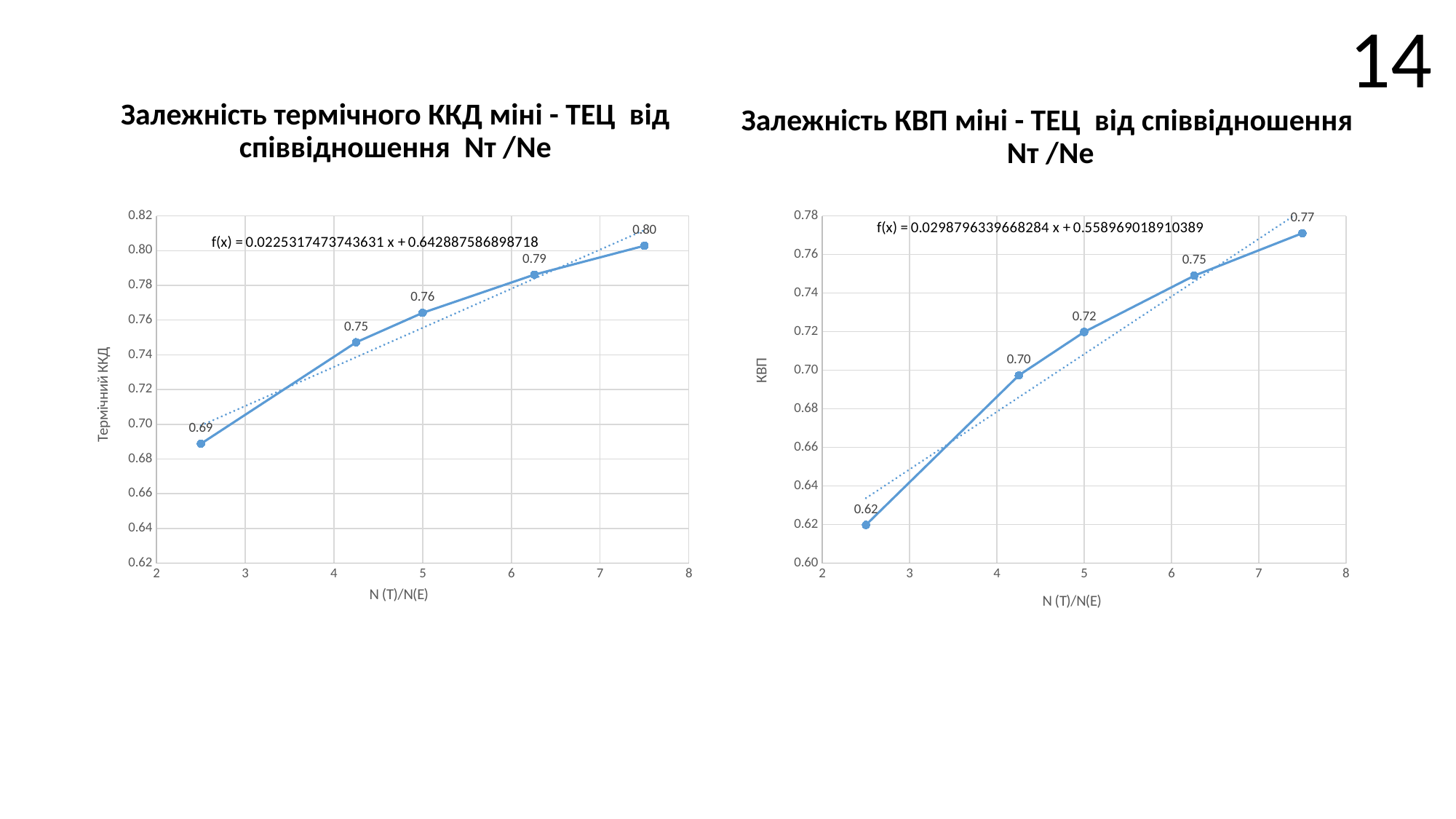
On the left chart (Залежність термічного ККД міні - ТЕЦ), do the values rise or fall as N (T)/N(E) increases? rise What is the x-axis title of the left chart (Залежність термічного ККД міні - ТЕЦ)? N (T)/N(E) On the right chart (Залежність КВП міні - ТЕЦ від співвідношення Nт /Ne), what is the data label of the first (leftmost) point? 0.62 On the right chart (Залежність КВП міні - ТЕЦ), what is the data label of the third point? 0.72 What is the y-axis title of the right chart (Залежність КВП міні - ТЕЦ)? КВП On the left chart (Залежність термічного ККД міні - ТЕЦ), what is the highest labelled value? 0.80 On the right chart (Залежність КВП міні - ТЕЦ), what is the difference between the last point's label (0.77) and the first point's label (0.62)? 0.15 On the left chart (Залежність термічного ККД міні - ТЕЦ), how many data points are plotted? 5 Which is larger: the second point on the left chart (0.75) or the second point on the right chart (0.70)? the left chart's second point (0.75) On the left chart (Залежність термічного ККД міні - ТЕЦ від співвідношення Nт /Ne), what is the data label of the first (leftmost) point? 0.69 On the left chart (Залежність термічного ККД міні - ТЕЦ), what is the data label of the last (rightmost) point? 0.80 On the right chart (Залежність КВП міні - ТЕЦ), what is the lowest labelled value? 0.62